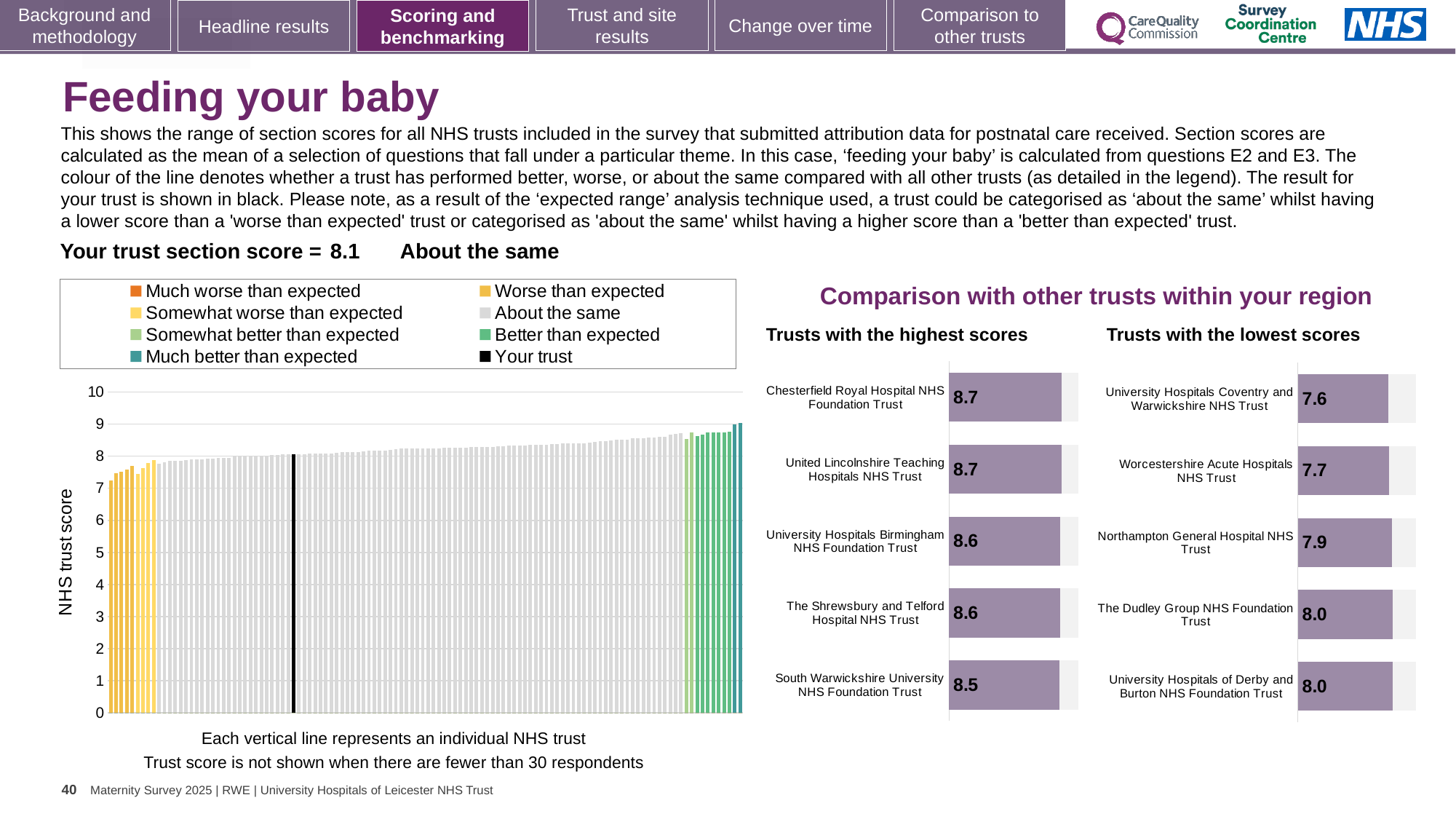
In the 'Trusts with the highest scores' chart, what is the score for South Warwickshire University NHS Foundation Trust? 8.5 In the main 'NHS trust score' chart on the left, how many entries does the legend list? 8 In the 'Trusts with the lowest scores' chart, what is the score for Northampton General Hospital NHS Trust? 7.9 In the 'Trusts with the lowest scores' chart, which trust has the lowest score? University Hospitals Coventry and Warwickshire NHS Trust In the main 'NHS trust score' chart on the left, do the bar values rise or fall from left to right? rise In the 'Trusts with the lowest scores' chart, which has the higher score: Worcestershire Acute Hospitals NHS Trust or Northampton General Hospital NHS Trust? Northampton General Hospital NHS Trust What is the section score for your trust shown on the slide? 8.1 In the 'Trusts with the highest scores' chart, what is the difference between the scores for Chesterfield Royal Hospital NHS Foundation Trust and South Warwickshire University NHS Foundation Trust? 0.2 What kind of chart is the main chart on the left of the slide? bar chart In the 'Trusts with the lowest scores' chart, what is the difference between the scores for University Hospitals of Derby and Burton NHS Foundation Trust and University Hospitals Coventry and Warwickshire NHS Trust? 0.4 In the 'Trusts with the highest scores' chart, how many trusts are listed? 5 In the 'Trusts with the highest scores' chart, what is the score for Chesterfield Royal Hospital NHS Foundation Trust? 8.7